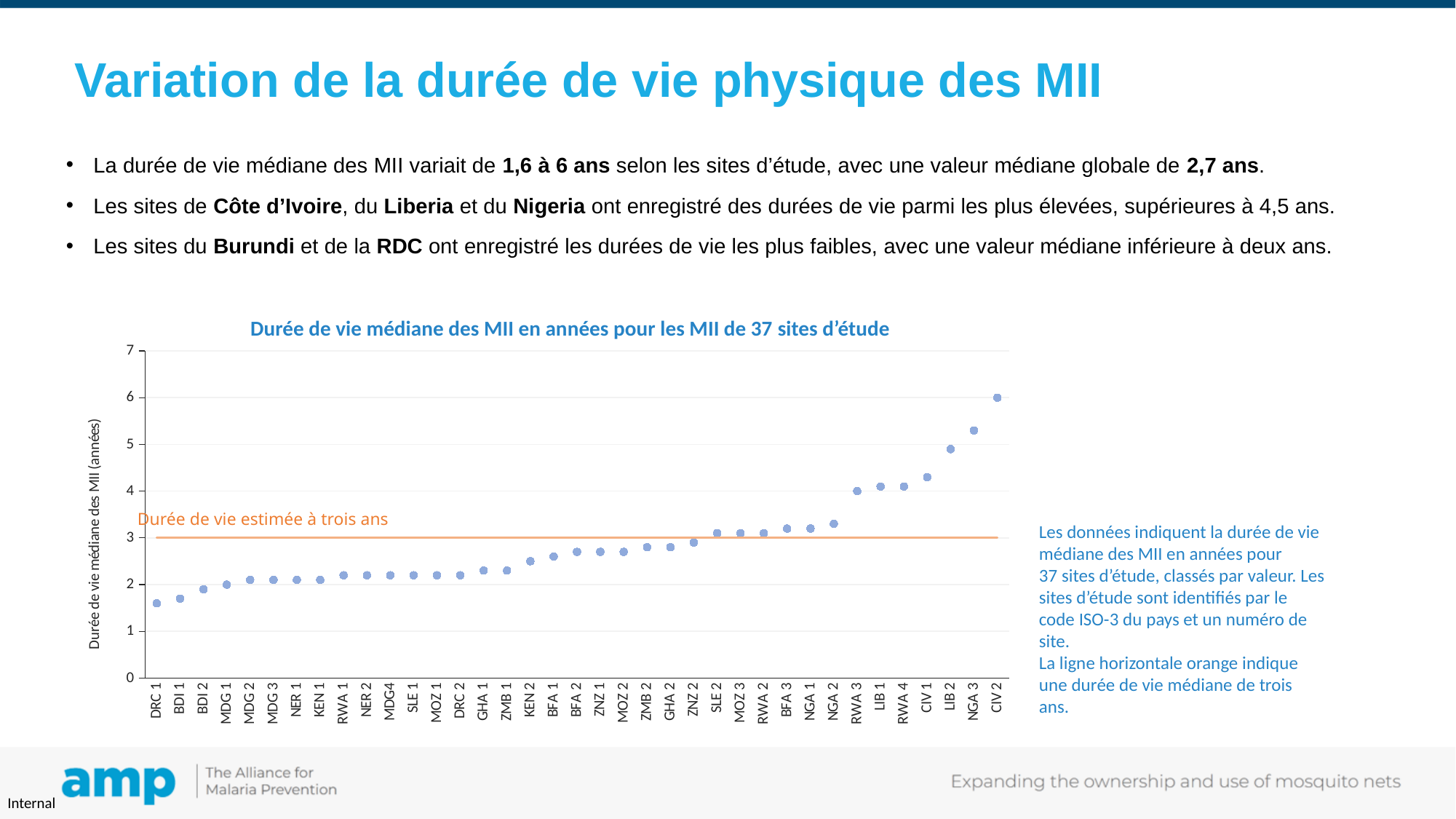
What lifespan does the orange horizontal line in the chart indicate? three years Which site has the lowest median lifespan in the chart? DRC 1 Is the value for RWA 3 greater or less than 3? greater What is the label of the vertical axis of the chart? Durée de vie médiane des MII (années) Do the plotted values rise or fall from left to right along the x axis? rise How many study sites are plotted in the chart? 37 Is the value for DRC 1 greater or less than 2? less What is the median lifespan in years for CIV 2? 6 Which site has the highest median lifespan in the chart? CIV 2 Which site has a larger median lifespan, LIB 2 or KEN 2? LIB 2 What kind of chart is shown on the slide? scatter chart Is the value for NGA 3 greater or less than 5? greater